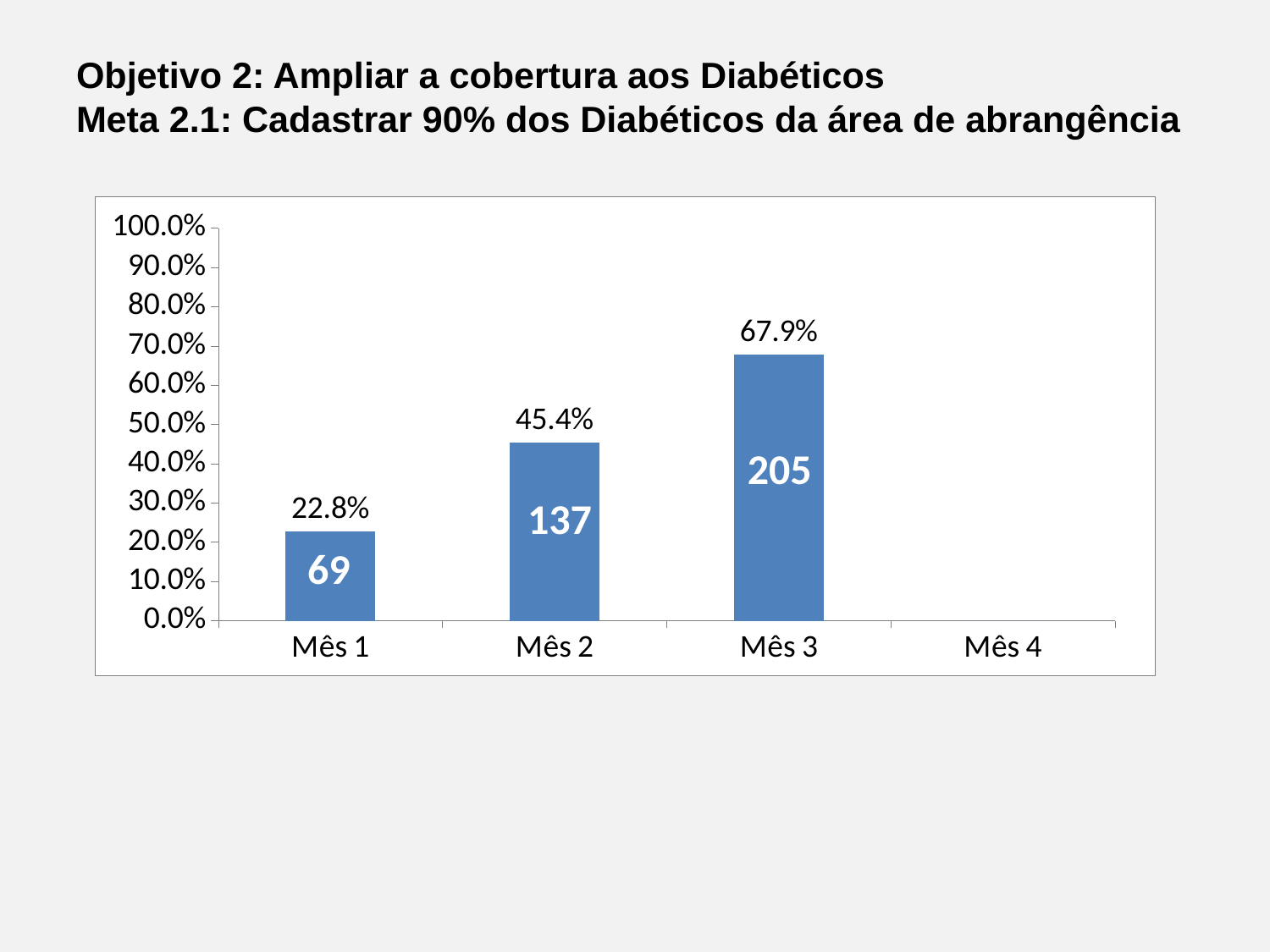
How many categories are shown on the x axis? 4 What kind of chart is shown on the slide? Bar chart What percentage is shown for Mês 1? 22.8% What is the difference in percentage points between Mês 3 and Mês 2? 22.5 What percentage is shown for Mês 3? 67.9% Which is larger, the percentage for Mês 1 or for Mês 2? Mês 2 What number is printed inside the bar for Mês 2? 137 What number is printed inside the bar for Mês 3? 205 Which month with a bar has the lowest percentage? Mês 1 Do the percentages rise or fall from Mês 1 to Mês 3? Rise What percentage is shown for Mês 2? 45.4% Which month has the highest percentage? Mês 3